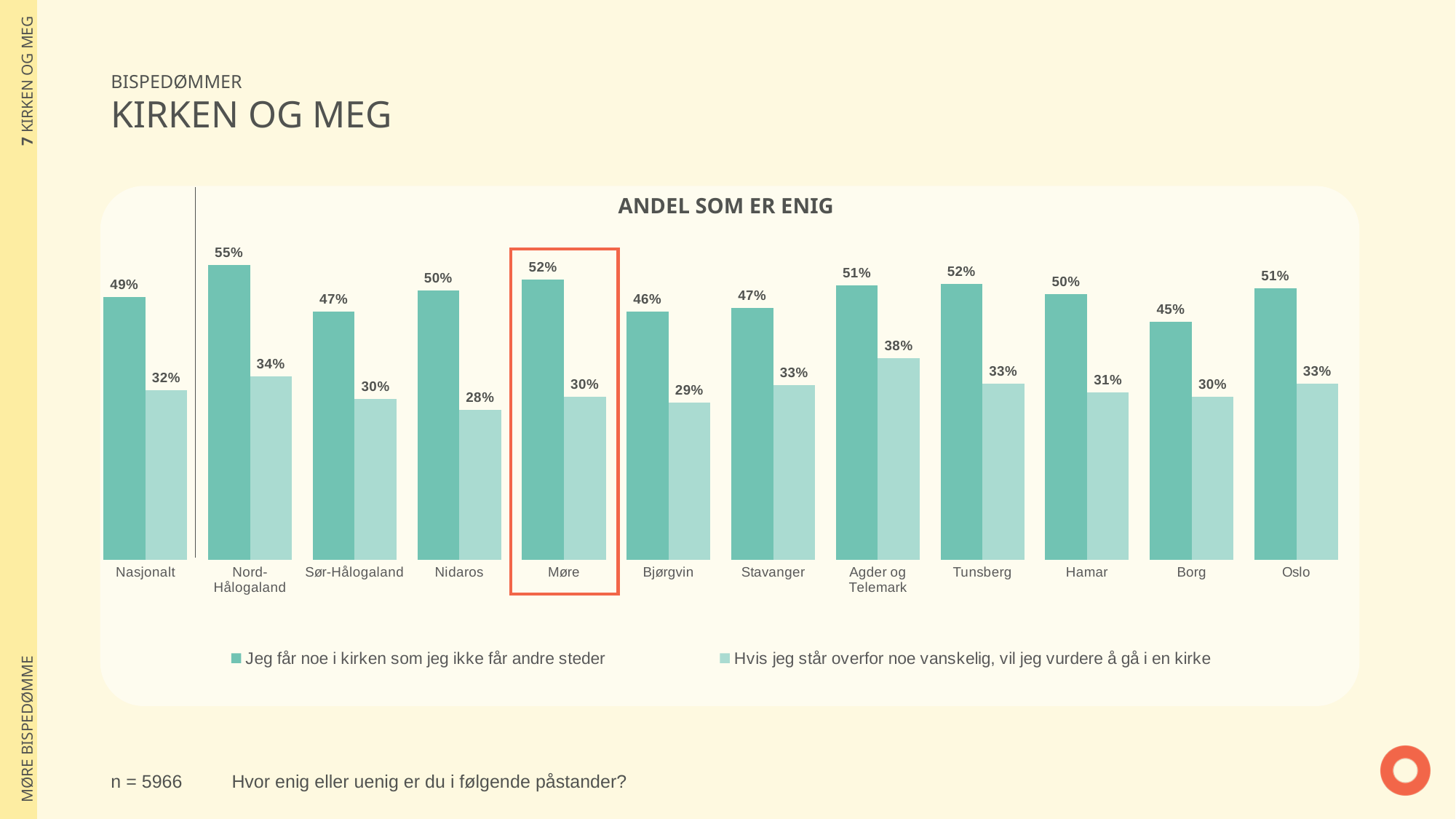
Which category has the highest value for the series 'Jeg får noe i kirken som jeg ikke får andre steder'? Nord-Hålogaland What is the title of the chart? ANDEL SOM ER ENIG What is the difference between the two series values for Nidaros? 22 percentage points Which category has the lowest value for the series 'Hvis jeg står overfor noe vanskelig, vil jeg vurdere å gå i en kirke'? Nidaros Which is larger: the 'Jeg får noe i kirken som jeg ikke får andre steder' value for Nord-Hålogaland or for Oslo? Nord-Hålogaland How many series does the legend list? 2 Which category has the highest value for the series 'Hvis jeg står overfor noe vanskelig, vil jeg vurdere å gå i en kirke'? Agder og Telemark What is the value for Nasjonalt for the series 'Hvis jeg står overfor noe vanskelig, vil jeg vurdere å gå i en kirke'? 32% How many categories are shown on the x axis? 12 What is the value for Møre for the series 'Jeg får noe i kirken som jeg ikke får andre steder'? 52% Which category has the lowest value for the series 'Jeg får noe i kirken som jeg ikke får andre steder'? Borg What type of chart is shown on the slide? bar chart